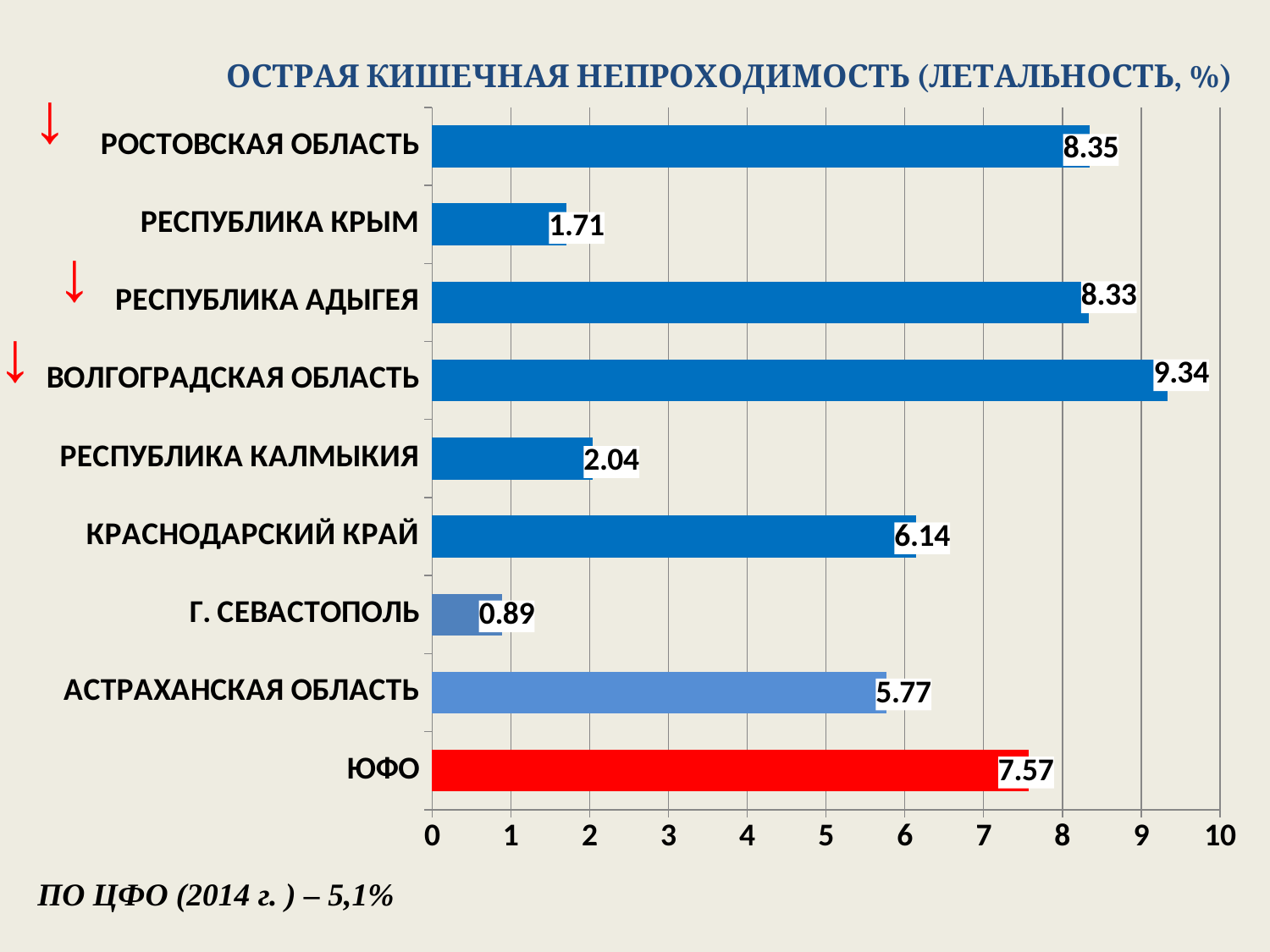
Which is larger, the value for Краснодарский край or the value for Астраханская область? Краснодарский край What kind of chart is shown on the slide? bar chart What is the title of the chart? ОСТРАЯ КИШЕЧНАЯ НЕПРОХОДИМОСТЬ (ЛЕТАЛЬНОСТЬ, %) Is the value for Республика Калмыкия greater or less than 3? less How many categories are shown in the chart? 9 What is the value for ЮФО? 7.57 What is the value for Волгоградская область? 9.34 What is the value for г. Севастополь? 0.89 Which category has the highest value? Волгоградская область What is the difference between the values for Ростовская область and Республика Крым? 6.64 Which category's bar is coloured red? ЮФО Which category has the lowest value? г. Севастополь